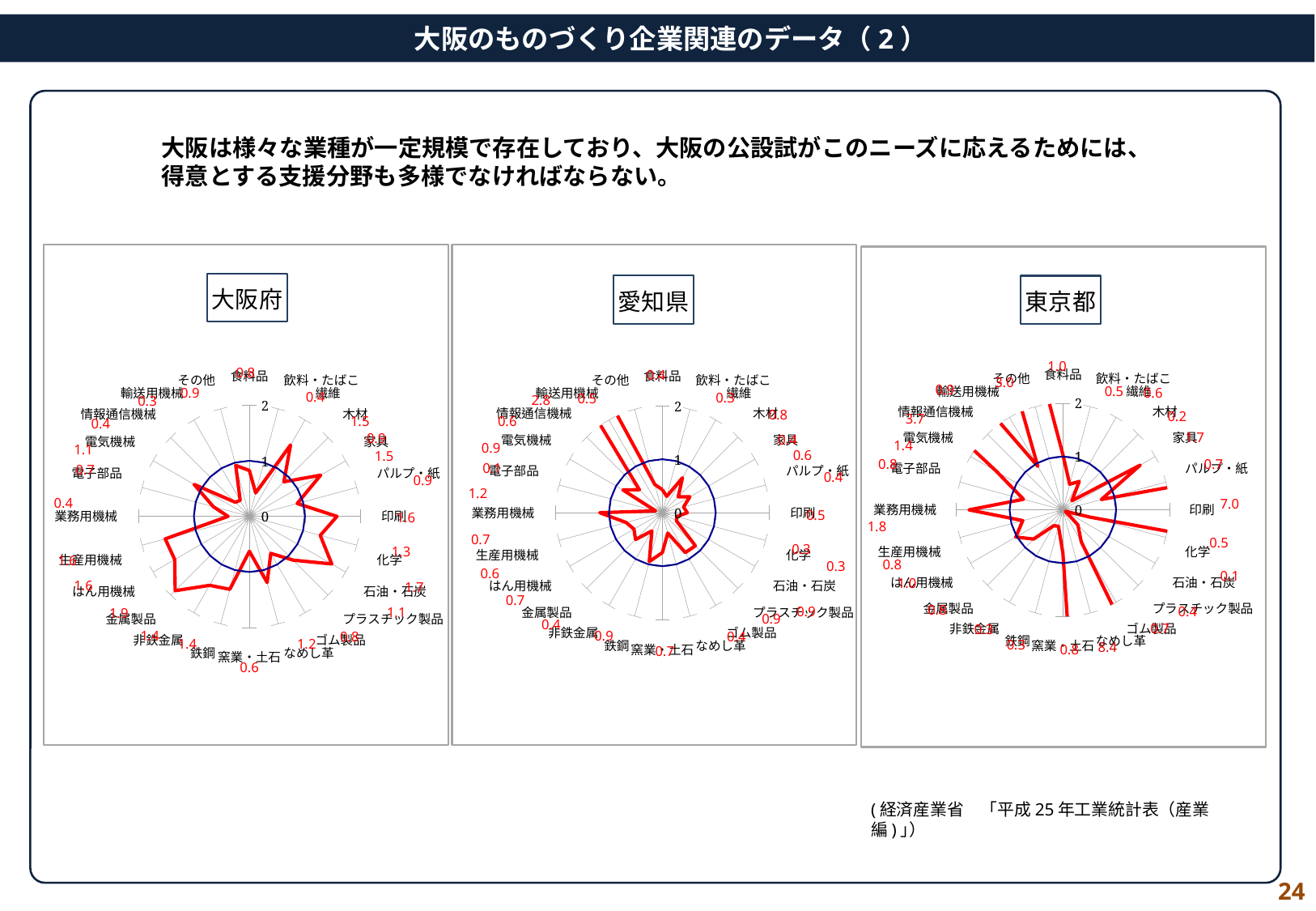
In the 愛知県 chart, what is the value for 輸送用機械? 2.8 In the 愛知県 chart, what is the value for 印刷? 0.5 How many radar charts are shown on the slide? 3 In the 東京都 chart, which category has the highest value? なめし革 In the 東京都 chart, which is larger, the value for 情報通信機械 or the value for 電気機械? 情報通信機械 What kind of chart is used for 大阪府, 愛知県 and 東京都 on this slide? Radar chart In the 大阪府 chart, what is the value for 業務用機械? 0.4 In the 大阪府 chart, what is the value for 石油・石炭? 1.7 In the 東京都 chart, what is the value for 印刷? 7.0 In the 東京都 chart, what is the difference between the value for 印刷 (7.0) and the value for 化学 (0.5)? 6.5 In the 愛知県 chart, which category has the highest value? 輸送用機械 In the 大阪府 chart, what is the value for 印刷? 1.6